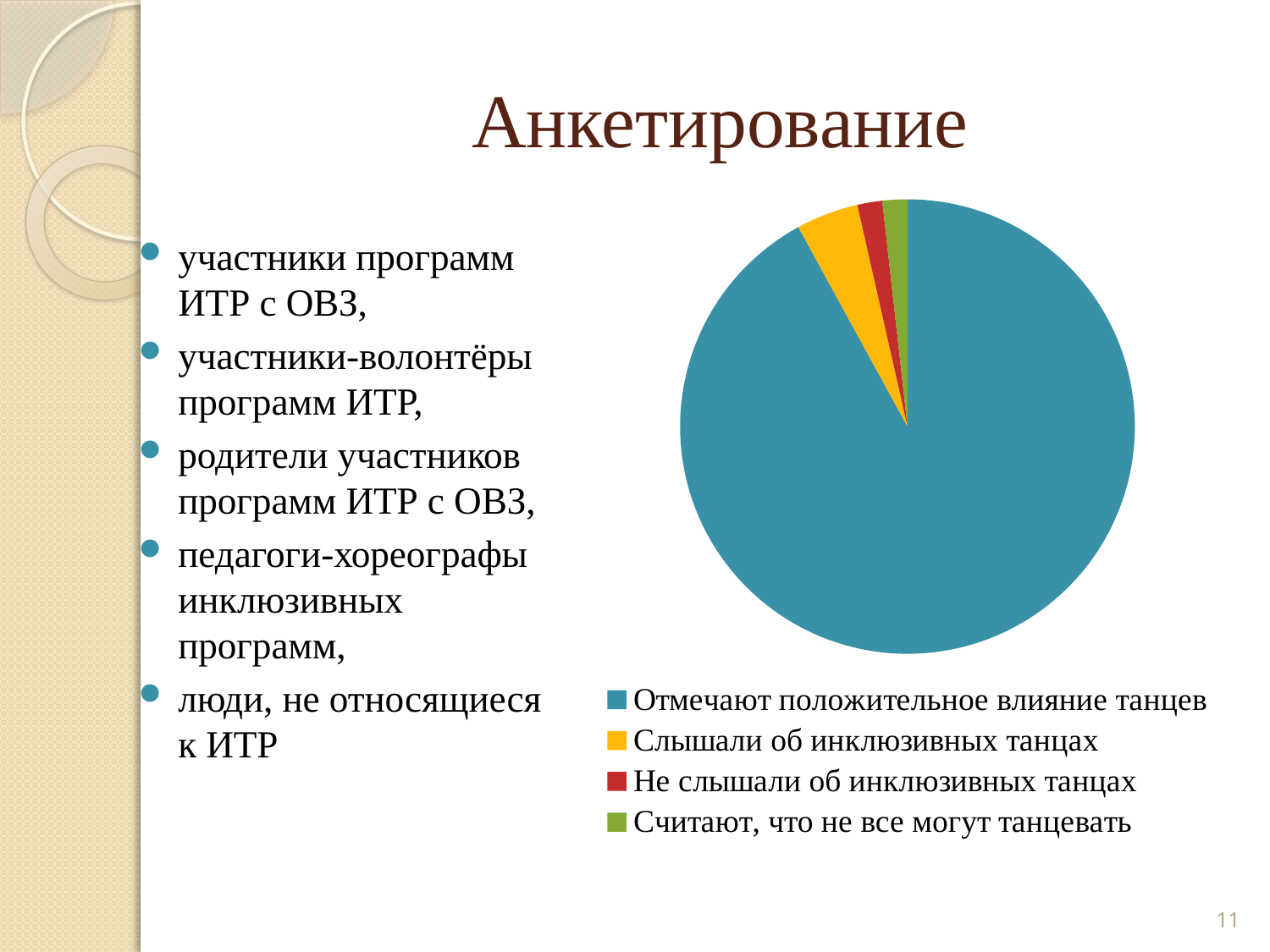
Which slice is larger: "Слышали об инклюзивных танцах" or "Не слышали об инклюзивных танцах"? Слышали об инклюзивных танцах How many entries does the legend of the pie chart list? 4 Does the slice "Отмечают положительное влияние танцев" take up more or less than half of the pie? more What kind of chart is shown on the slide? pie chart Which slice is larger: "Слышали об инклюзивных танцах" or "Считают, что не все могут танцевать"? Слышали об инклюзивных танцах Which legend entry is shown in green? Считают, что не все могут танцевать How many slices does the pie chart have? 4 Which category has the largest slice in the pie chart? Отмечают положительное влияние танцев Which slice is larger: "Отмечают положительное влияние танцев" or "Слышали об инклюзивных танцах"? Отмечают положительное влияние танцев What colour is the slice for "Слышали об инклюзивных танцах"? yellow